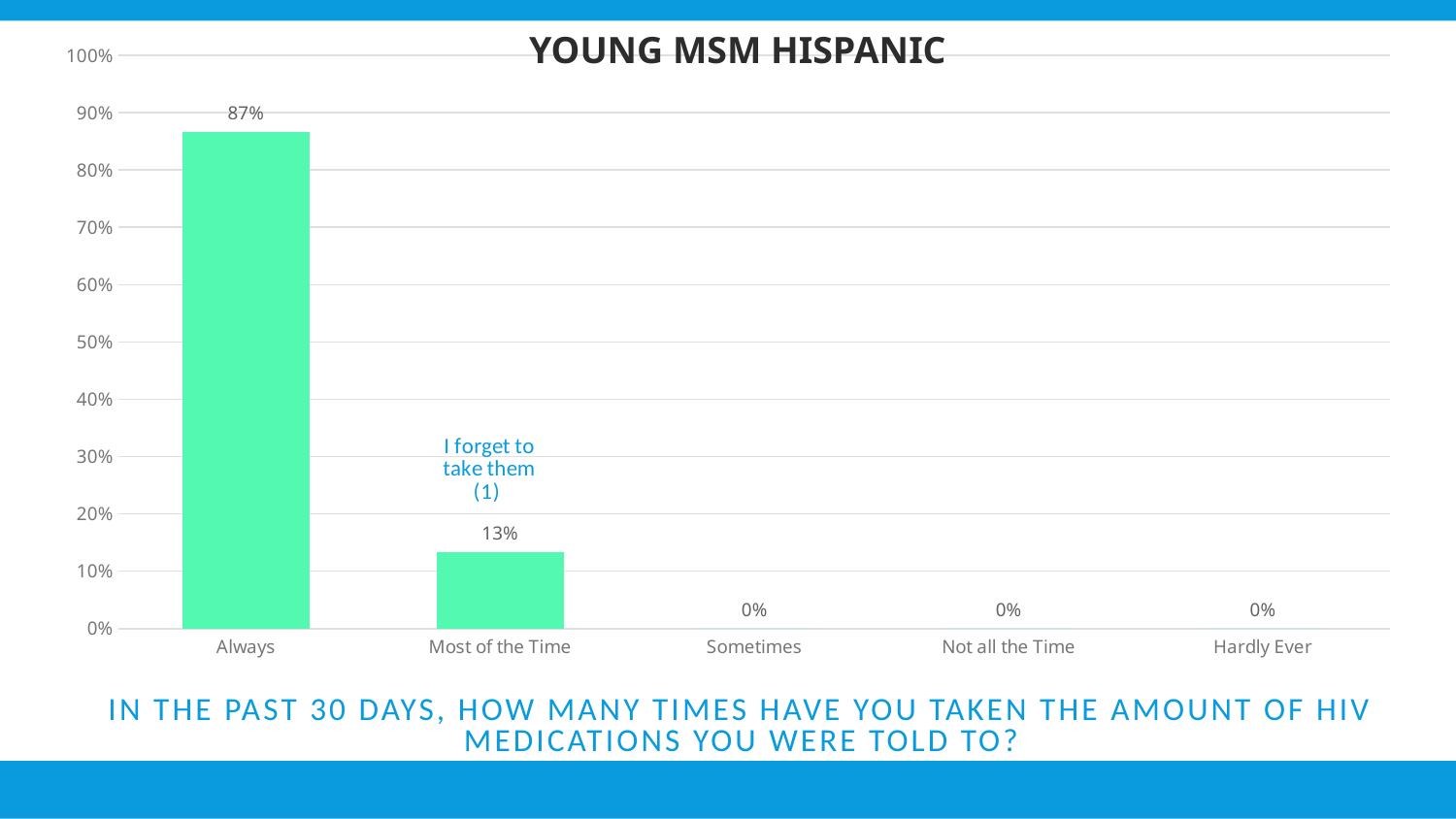
Do the values rise or fall from Always to Hardly Ever along the x axis? fall What kind of chart is shown? bar chart How many categories are shown on the x axis? 5 Is the value for Most of the Time greater or less than 20%? less Which is larger, the value for Always or the value for Most of the Time? Always What is the difference between the values for Always and Most of the Time? 74% What is the title of the chart? YOUNG MSM HISPANIC Is the value for Always greater or less than 80%? greater What is the value for Most of the Time? 13% What is the value for Always? 87% What is the value for Sometimes? 0% Which category has the highest value? Always